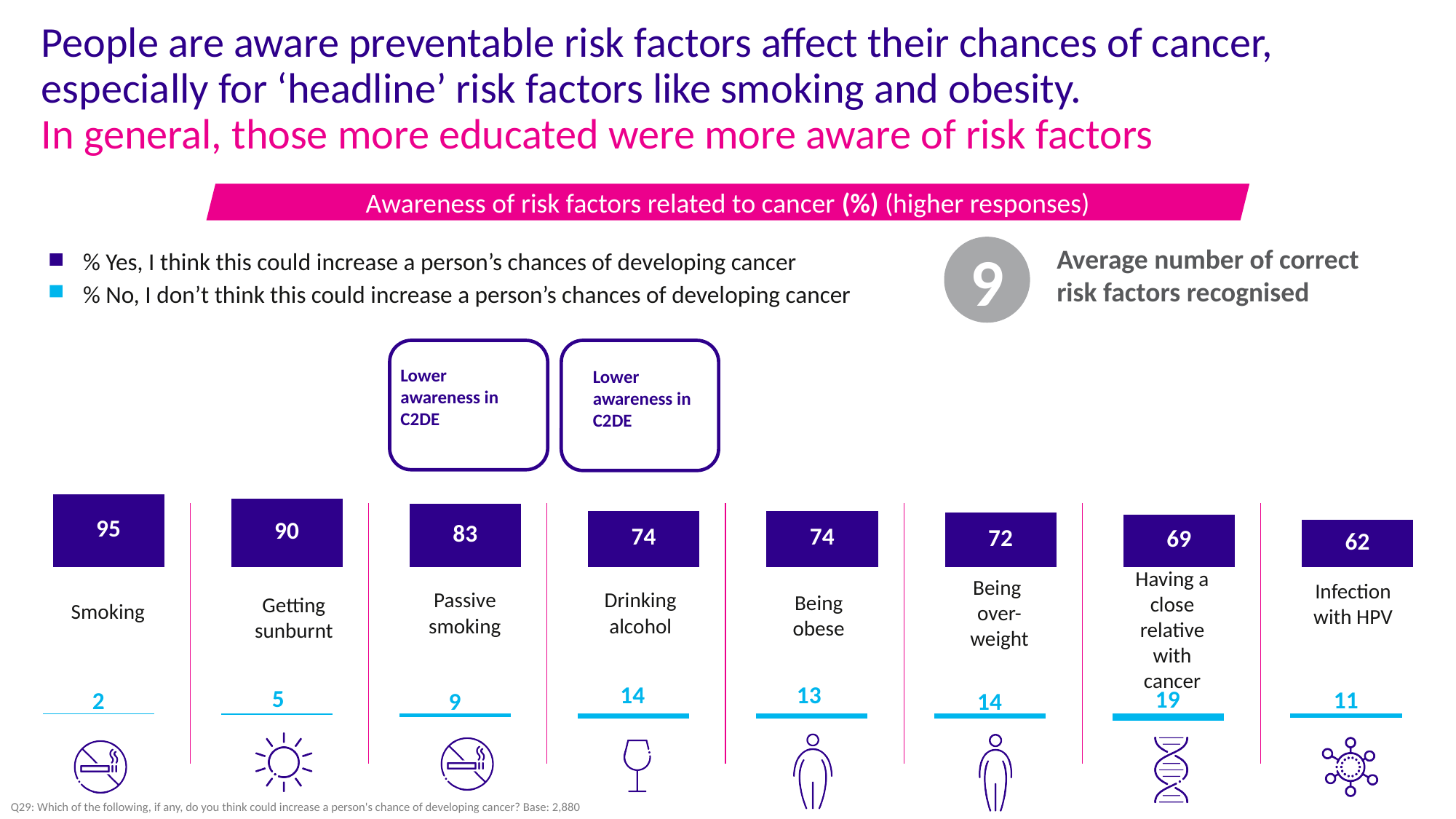
What kind of chart is used to show awareness of risk factors? Bar chart Which risk factor has the lowest '% Yes' awareness value? Infection with HPV What is the '% No' value for having a close relative with cancer? 19 What is the average number of correct risk factors recognised, as shown on the slide? 9 What percentage of respondents said smoking could increase a person's chances of developing cancer? 95 How many series does the legend list? 2 Which risk factor has the highest '% Yes' awareness value? Smoking How many risk factors are shown in the chart? 8 What is the difference between the '% Yes' values for smoking and getting sunburnt? 5 Which has a higher '% Yes' value: passive smoking or being overweight? Passive smoking Do the '% Yes' values rise or fall from left to right across the risk factors? Fall Which risk factor has the lowest '% No' value? Smoking